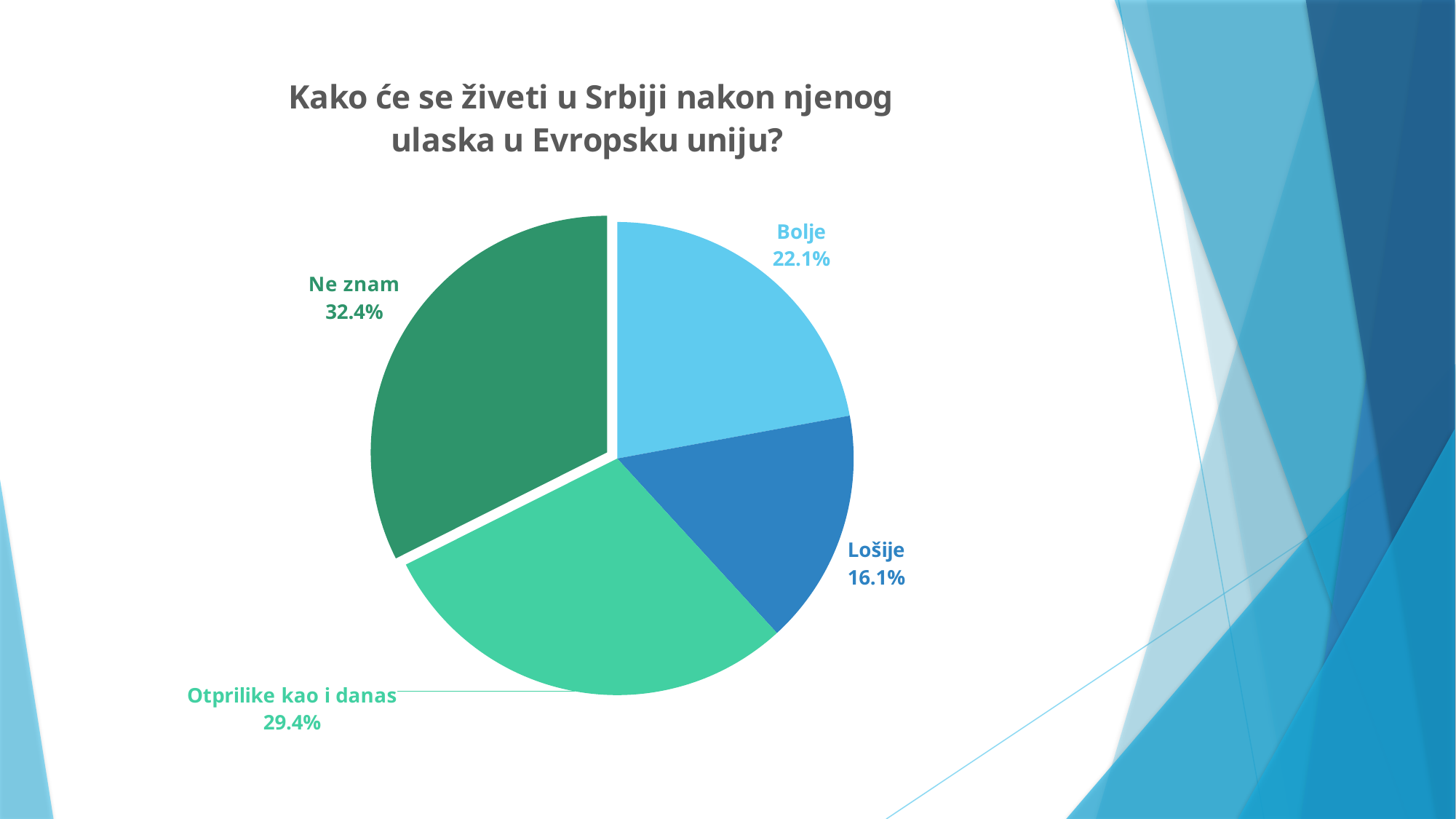
What percentage of respondents answered "Bolje"? 22.1% What percentage of respondents answered "Otprilike kao i danas"? 29.4% What kind of chart is shown on the slide? Pie chart What percentage of respondents answered "Ne znam"? 32.4% Which response has the largest share of the pie? Ne znam What is the difference in percentage points between "Otprilike kao i danas" and "Bolje"? 7.3 What percentage of respondents answered "Lošije"? 16.1% Which response has the smallest share of the pie? Lošije What is the difference in percentage points between "Ne znam" and "Lošije"? 16.3 How many slices does the pie chart have? 4 Which is larger, the share for "Bolje" or the share for "Lošije"? Bolje What is the title of the chart? Kako će se živeti u Srbiji nakon njenog ulaska u Evropsku uniju?